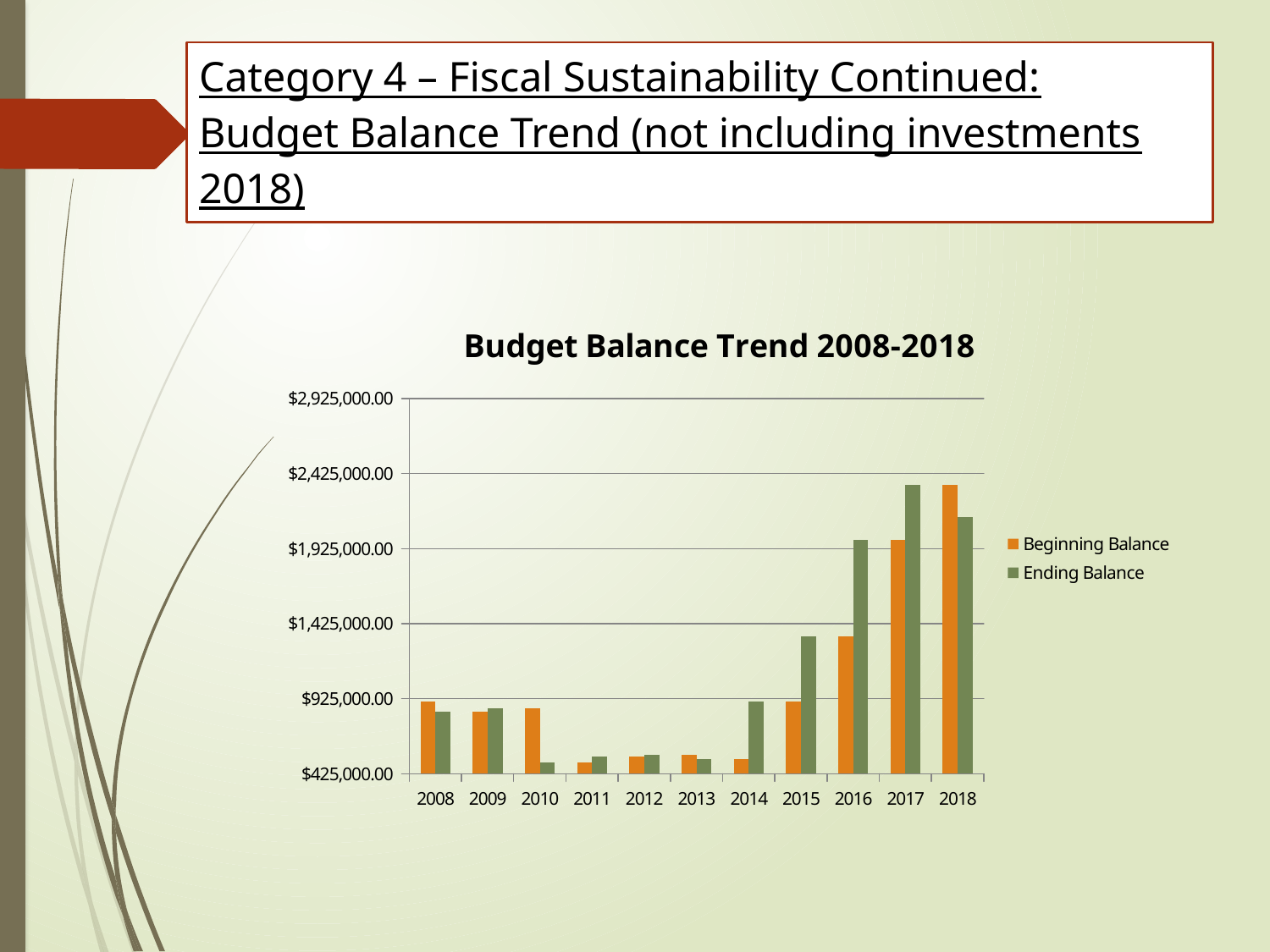
How many years are shown on the x axis of the chart? 11 Is the Ending Balance for 2015 greater or less than $1,425,000.00? less Does the Ending Balance rise or fall from 2014 to 2017? Rise In which year is the Ending Balance highest? 2017 What kind of chart is shown on the slide? Bar chart What is the title of the chart? Budget Balance Trend 2008-2018 How many series does the legend list? 2 Is the Beginning Balance for 2011 greater or less than $925,000.00? less In 2018, which is larger, the Beginning Balance or the Ending Balance? Beginning Balance In which year is the Beginning Balance highest? 2018 Which colour represents the Ending Balance series? Green Is the Ending Balance for 2017 greater or less than $1,925,000.00? greater